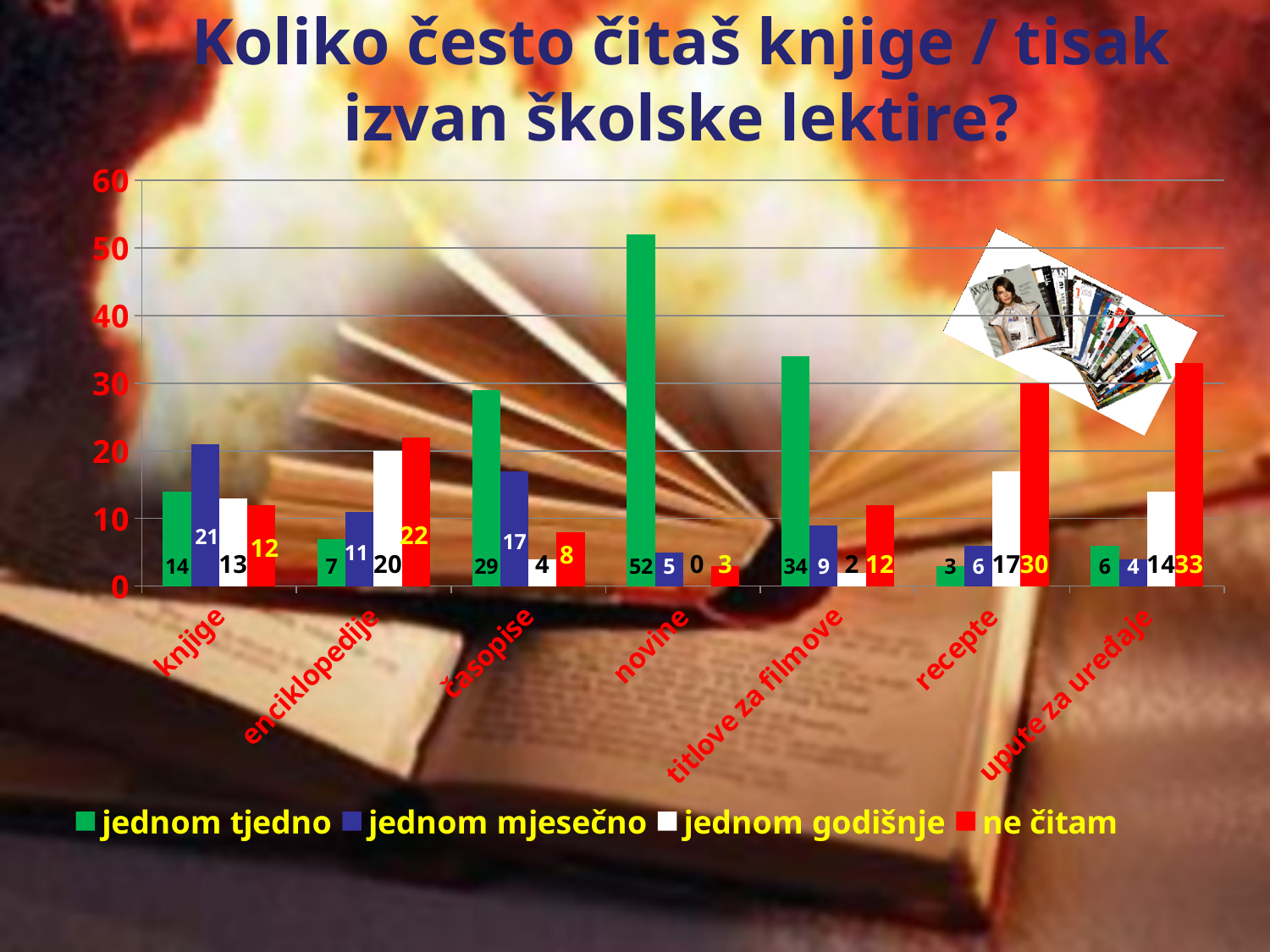
What is the value for 'jednom tjedno' in the 'novine' category? 52 Is the value for 'jednom tjedno' in the 'titlove za filmove' category greater or less than 30? greater How many series does the legend list? 4 Which category has the lowest value for 'jednom godišnje'? novine What is the value for 'jednom godišnje' in the 'enciklopedije' category? 20 Which category has the highest value for 'jednom tjedno'? novine Which is larger in the 'knjige' category: 'jednom tjedno' or 'jednom mjesečno'? jednom mjesečno Which series is shown in red in the legend? ne čitam How many categories are shown on the x axis? 7 What is the difference between 'ne čitam' and 'jednom tjedno' in the 'recepte' category? 27 What is the value for 'ne čitam' in the 'upute za uređaje' category? 33 What kind of chart is shown on the slide? bar chart